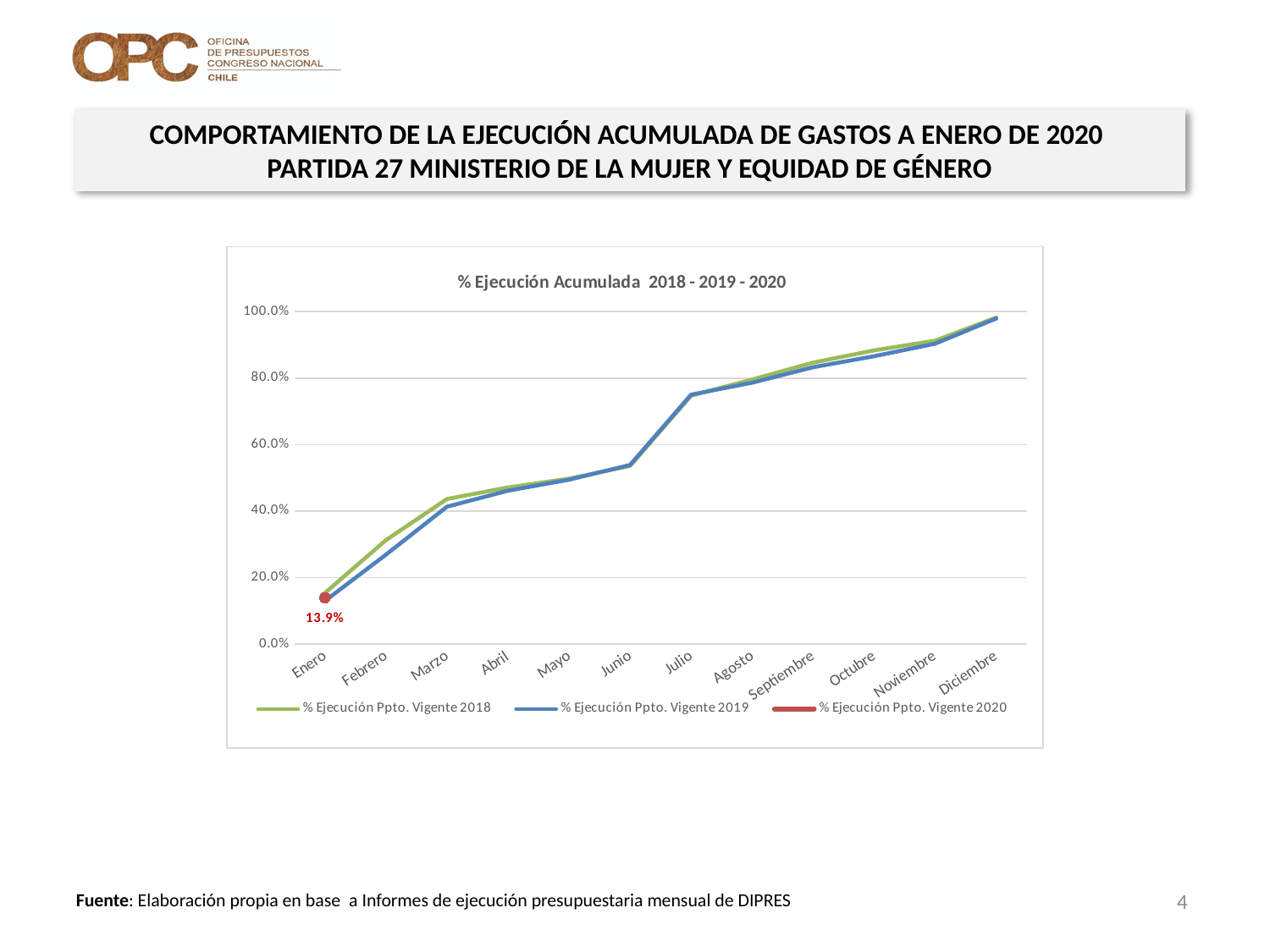
How many months are shown along the x axis of the chart? 12 Is the value for % Ejecución Ppto. Vigente 2019 in Enero greater or less than 20.0%? less Which month has the highest value for % Ejecución Ppto. Vigente 2019? Diciembre Is the value for % Ejecución Ppto. Vigente 2019 in Junio greater or less than 60.0%? less How many series does the chart legend list? 3 What is the value for % Ejecución Ppto. Vigente 2020 in Enero? 13.9% What is the title of the chart? % Ejecución Acumulada 2018 - 2019 - 2020 Is the value for % Ejecución Ppto. Vigente 2019 in Julio greater or less than 60.0%? greater In Marzo, which series has the higher value: % Ejecución Ppto. Vigente 2018 or % Ejecución Ppto. Vigente 2019? % Ejecución Ppto. Vigente 2018 What kind of chart is shown on the slide? line chart Do the values for % Ejecución Ppto. Vigente 2018 rise or fall from Enero to Diciembre? rise